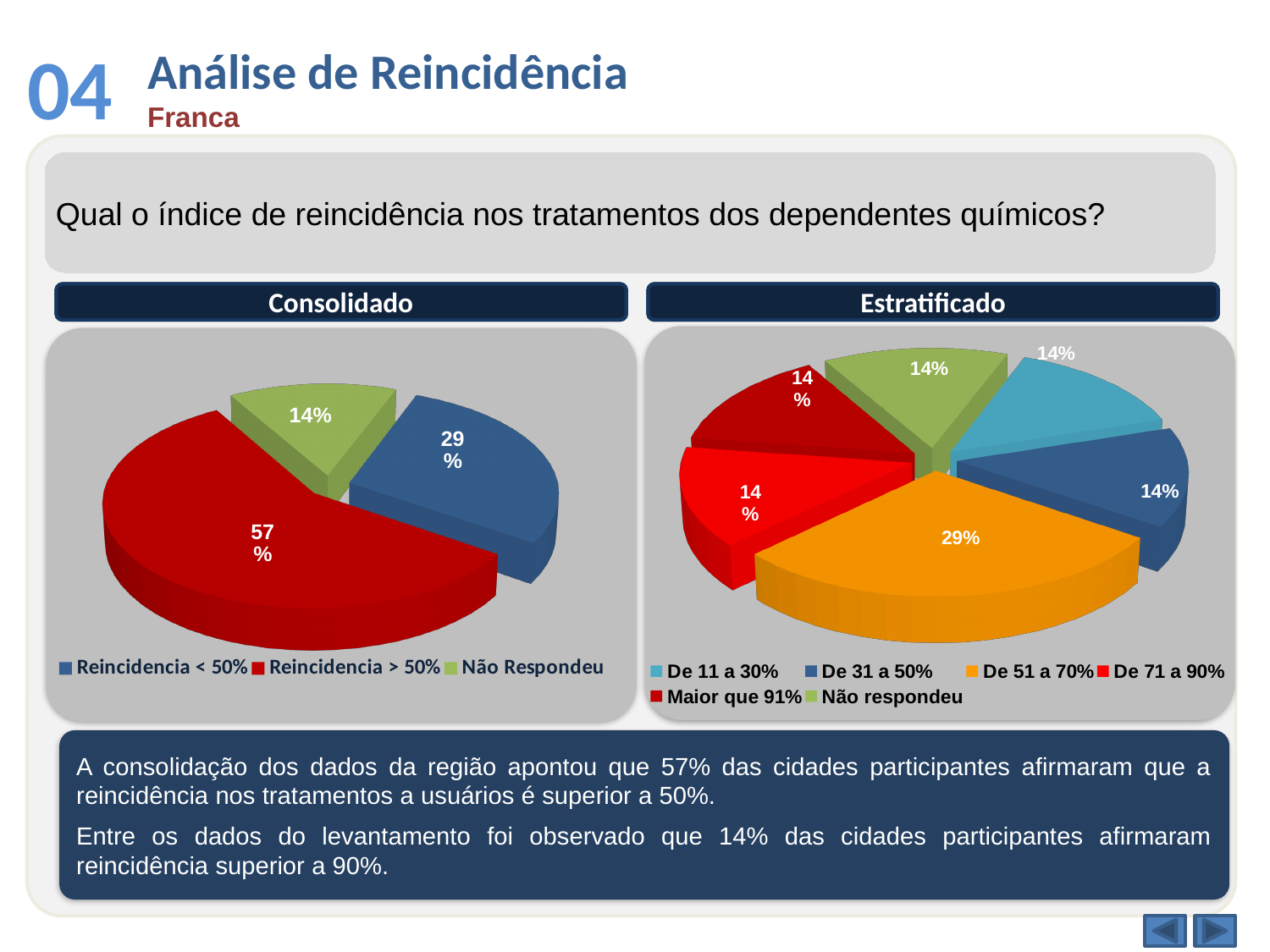
In the Consolidado chart, which category has the largest slice? Reincidencia > 50% In the Consolidado chart, which category has the smallest slice? Não Respondeu In the Consolidado chart, what share is labelled for Reincidencia < 50%? 29% In the Consolidado chart, what is the difference in percentage points between Reincidencia > 50% and Reincidencia < 50%? 28 In the Estratificado chart, how many categories does the legend list? 6 In the Consolidado chart, what share is labelled for Não Respondeu? 14% What type of chart is the Consolidado chart? pie chart In the Consolidado chart, what share is labelled for Reincidencia > 50%? 57% In the Consolidado chart, what colour is the Reincidencia > 50% slice? red In the Estratificado chart, what share is labelled for De 51 a 70%? 29% In the Estratificado chart, is the slice for De 51 a 70% larger or smaller than the slice for De 31 a 50%? larger In the Estratificado chart, which category has the largest slice? De 51 a 70%